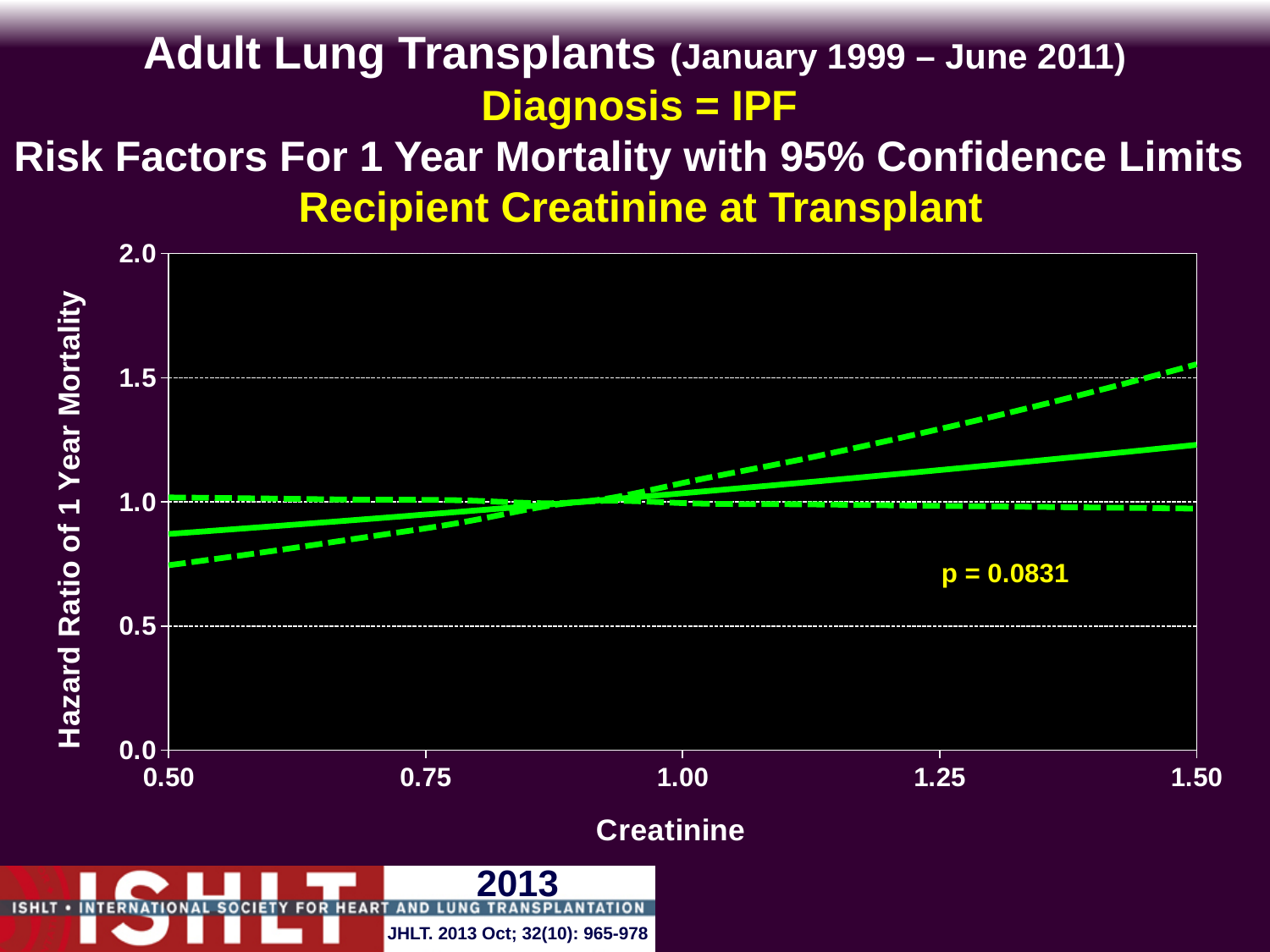
What is the label of the x axis? Creatinine How many lines are plotted on the chart? 3 What p-value is printed on the chart? p = 0.0831 Is the hazard ratio (solid line) at a creatinine of 1.50 greater or less than 1.5? less Is the lower 95% confidence limit (lower dashed line) at a creatinine of 0.50 greater or less than 1.0? less What is the highest value shown on the y axis? 2.0 Does the solid hazard ratio line rise or fall as creatinine increases from 0.50 to 1.50? rise Is the upper 95% confidence limit (upper dashed line) at a creatinine of 1.50 greater or less than 1.0? greater What kind of chart is shown on the slide? line chart What is the lowest creatinine value shown on the x axis? 0.50